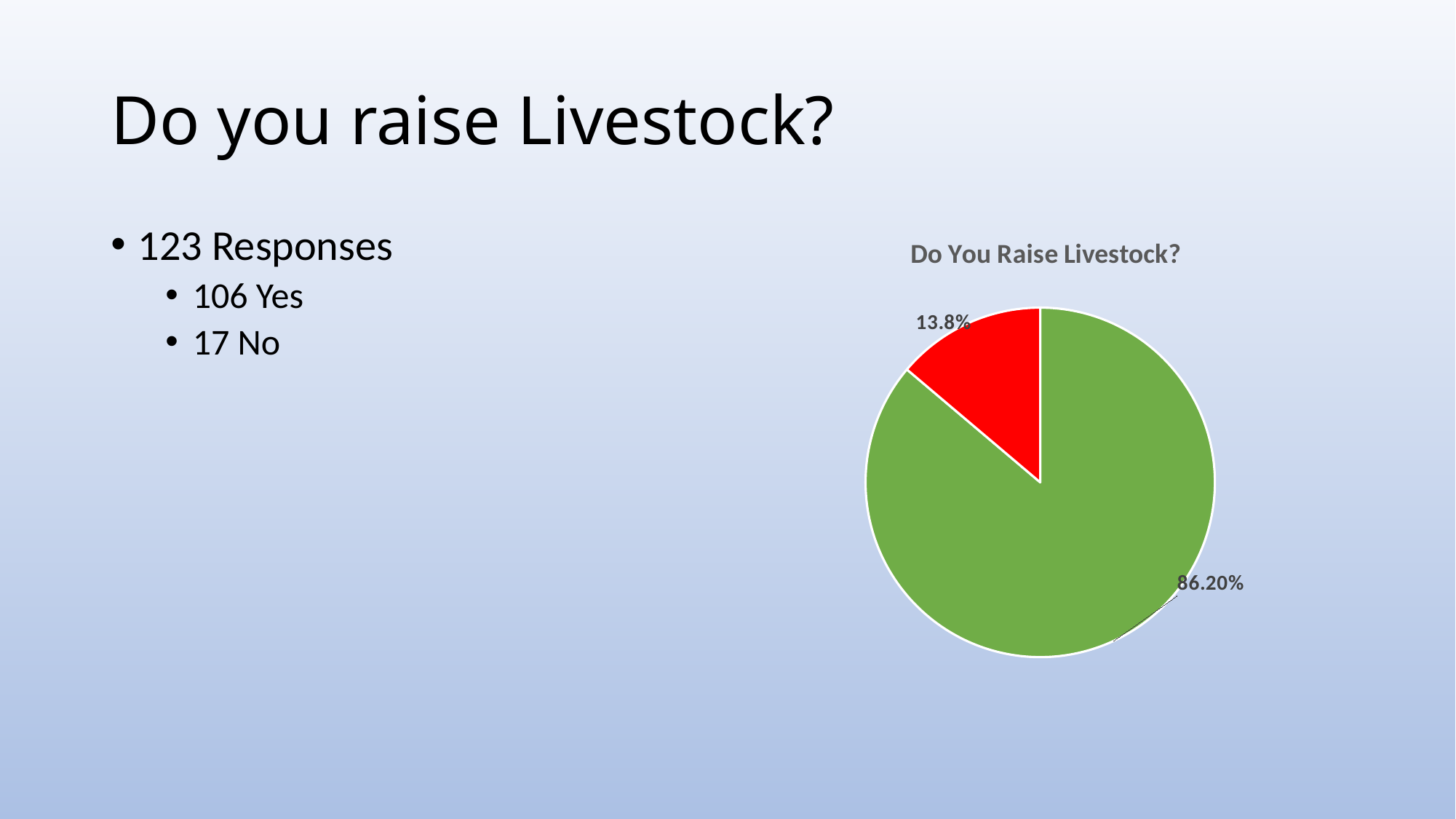
How many slices does the pie chart have? 2 What percentage is shown on the red slice of the pie chart? 13.8% What percentage is shown on the green slice of the pie chart? 86.20% Is the share of the red slice greater or less than 25%? less What colour is the slice labelled 13.8%? red Which slice of the pie chart is the largest? the green slice (86.20%) What is the title of the chart? Do You Raise Livestock? What share of the pie does the slice labelled 86.20% represent? 86.20% Which slice of the pie chart is the smallest? the red slice (13.8%) What kind of chart is shown on the slide? pie chart Which slice of the pie chart is larger, the green one or the red one? green Is the share of the green slice greater or less than 50%? greater